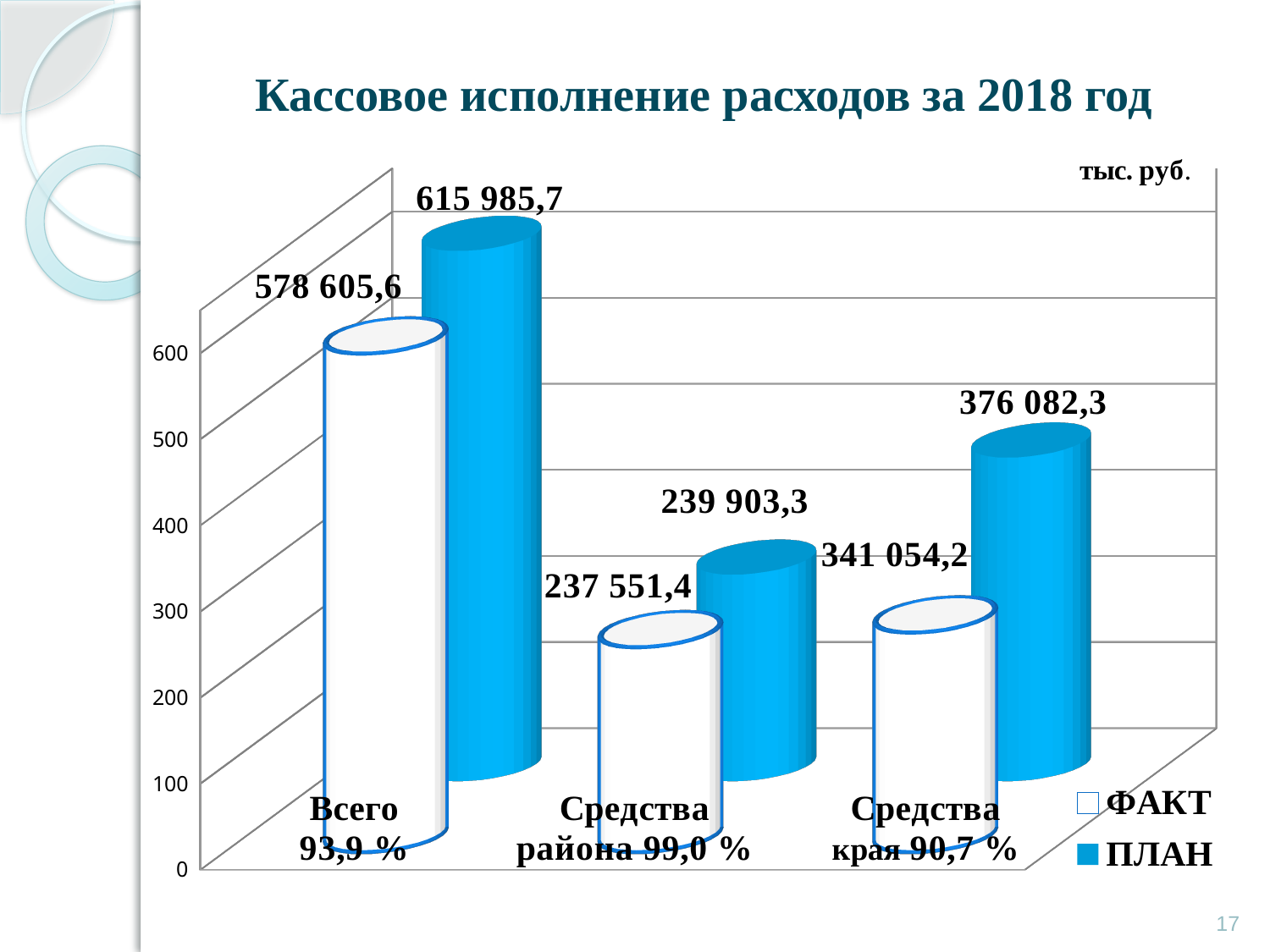
What is the ФАКТ value for Средства района? 237 551,4 What is the difference between the ПЛАН and ФАКТ values for Всего? 37 380,1 What is the ФАКТ value for Всего? 578 605,6 What is the ПЛАН value for Средства края? 376 082,3 What is the ПЛАН value for Всего? 615 985,7 How many categories are shown on the x axis? 3 Which category has the highest ПЛАН value? Всего How many series does the legend list? 2 What is the difference between the ПЛАН and ФАКТ values for Средства края? 35 028,1 What kind of chart is shown on the slide? Bar chart Which category has the lowest ФАКТ value? Средства района Which is larger, the ПЛАН value for Средства края or the ПЛАН value for Средства района? Средства края